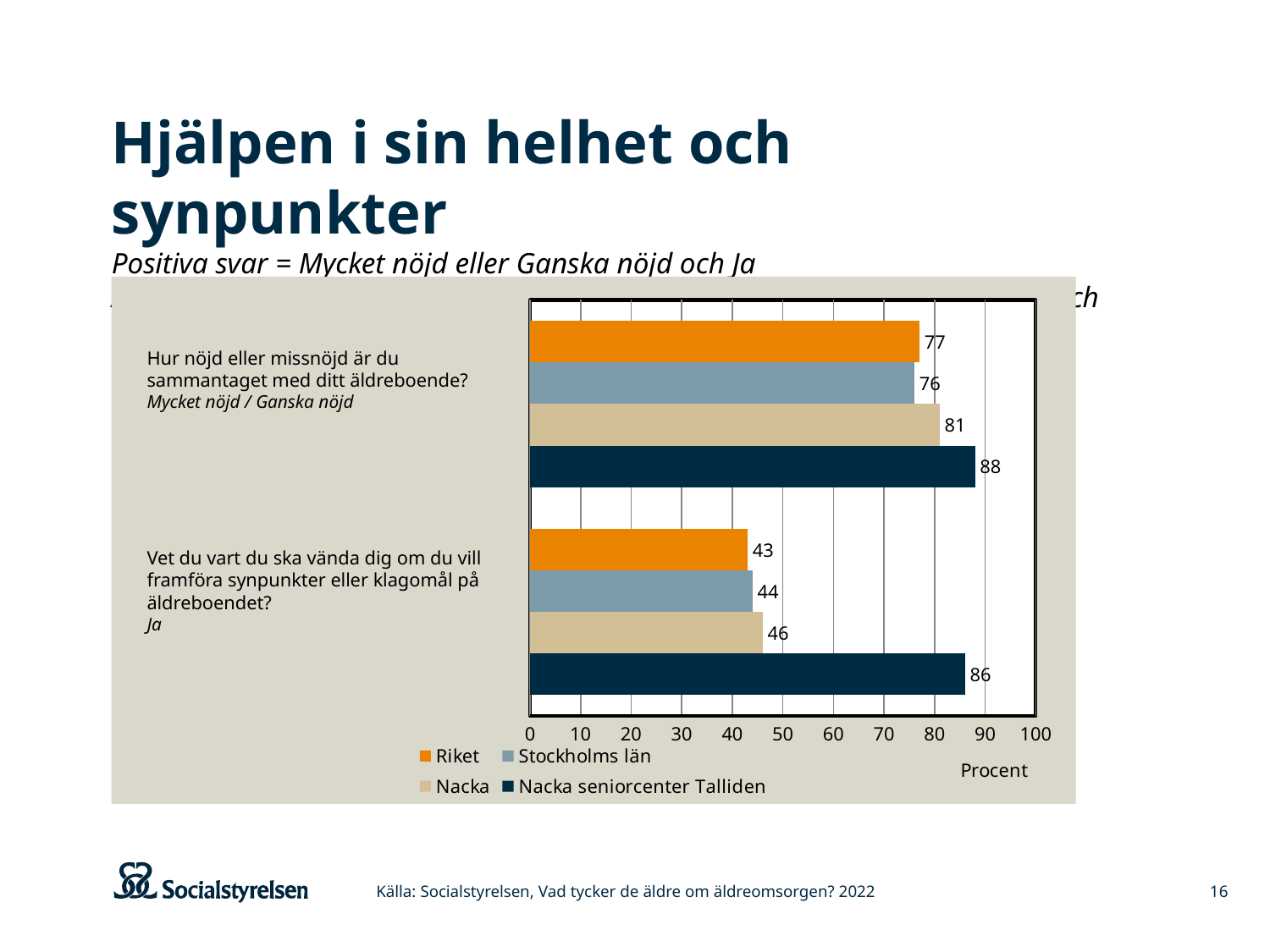
What value does Riket have for the question 'Vet du vart du ska vända dig om du vill framföra synpunkter eller klagomål på äldreboendet?' 43 What is the difference between Nacka seniorcenter Talliden and Nacka for the question 'Hur nöjd eller missnöjd är du sammantaget med ditt äldreboende?' 7 What value does Nacka have for the question 'Vet du vart du ska vända dig om du vill framföra synpunkter eller klagomål på äldreboendet?' 46 What kind of chart is shown on the slide? Bar chart What is the label of the horizontal axis of the chart? Procent What is the difference between Nacka seniorcenter Talliden and Riket for the question 'Vet du vart du ska vända dig om du vill framföra synpunkter eller klagomål på äldreboendet?' 43 Which is larger for the question 'Hur nöjd eller missnöjd är du sammantaget med ditt äldreboende?': Riket or Nacka? Nacka Which series has the highest value for the question 'Vet du vart du ska vända dig om du vill framföra synpunkter eller klagomål på äldreboendet?' Nacka seniorcenter Talliden Which series has the lowest value for the question 'Hur nöjd eller missnöjd är du sammantaget med ditt äldreboende?' Stockholms län What value does Stockholms län have for the question 'Hur nöjd eller missnöjd är du sammantaget med ditt äldreboende?' 76 What value does Nacka seniorcenter Talliden have for the question 'Hur nöjd eller missnöjd är du sammantaget med ditt äldreboende?' 88 How many series does the legend list? 4